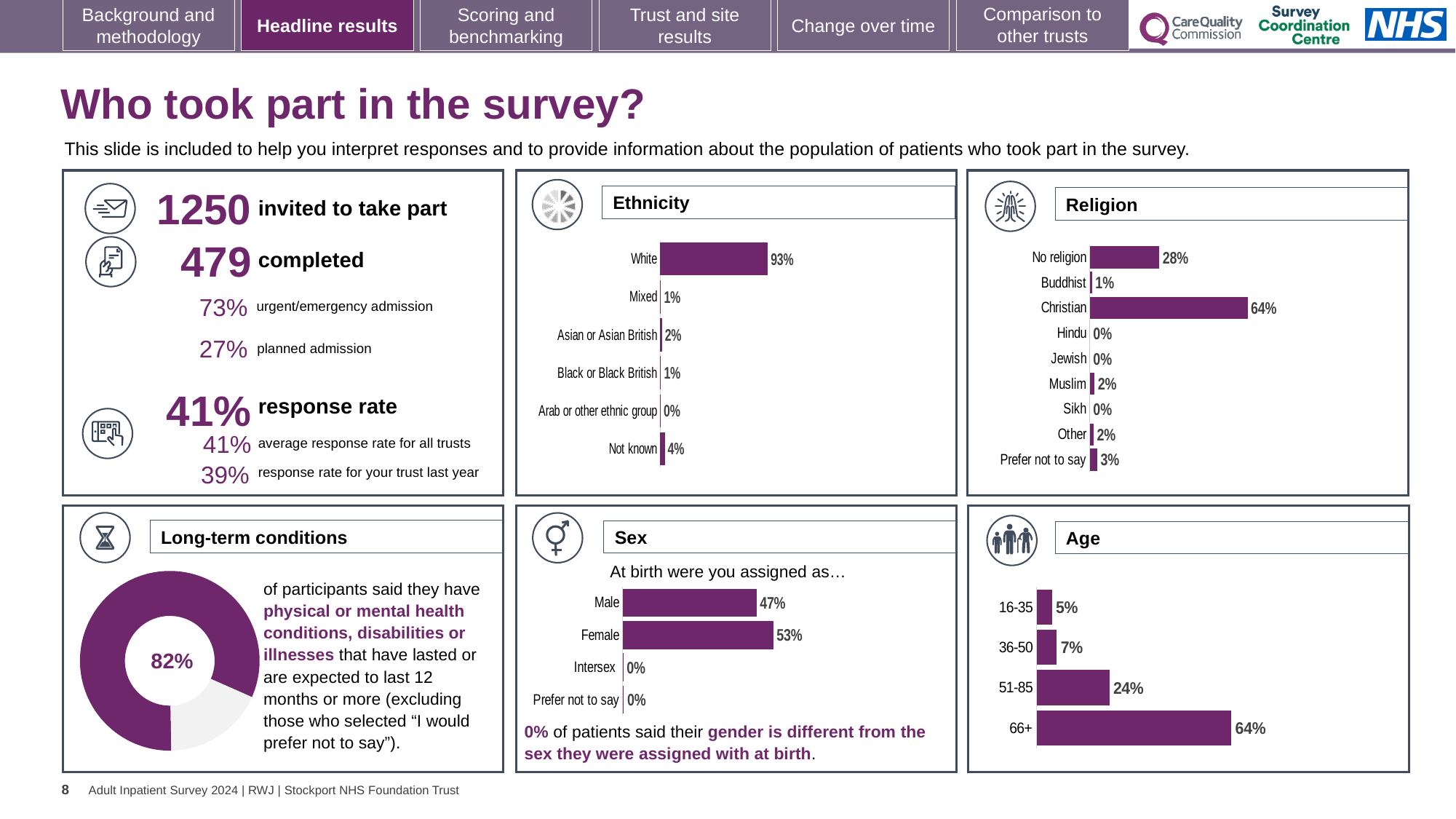
In the Religion chart, what is the value for No religion? 28% In the Age chart, which age group has the lowest value? 16-35 In the Sex chart, what is the difference between Female and Male? 6% In the Age chart, do the values rise or fall as age increases from 16-35 to 66+? rise In the Religion chart, which category has the highest value? Christian In the Ethnicity chart, what percentage of respondents are Not known? 4% In the Sex chart, which is larger, Male or Female? Female How many categories are shown in the Religion chart? 9 In the Ethnicity chart, what percentage of respondents are White? 93% What kind of chart is the Long-term conditions chart? Doughnut chart In the Age chart, what is the value for 51-85? 24% In the Religion chart, what is the difference between Christian and No religion? 36%